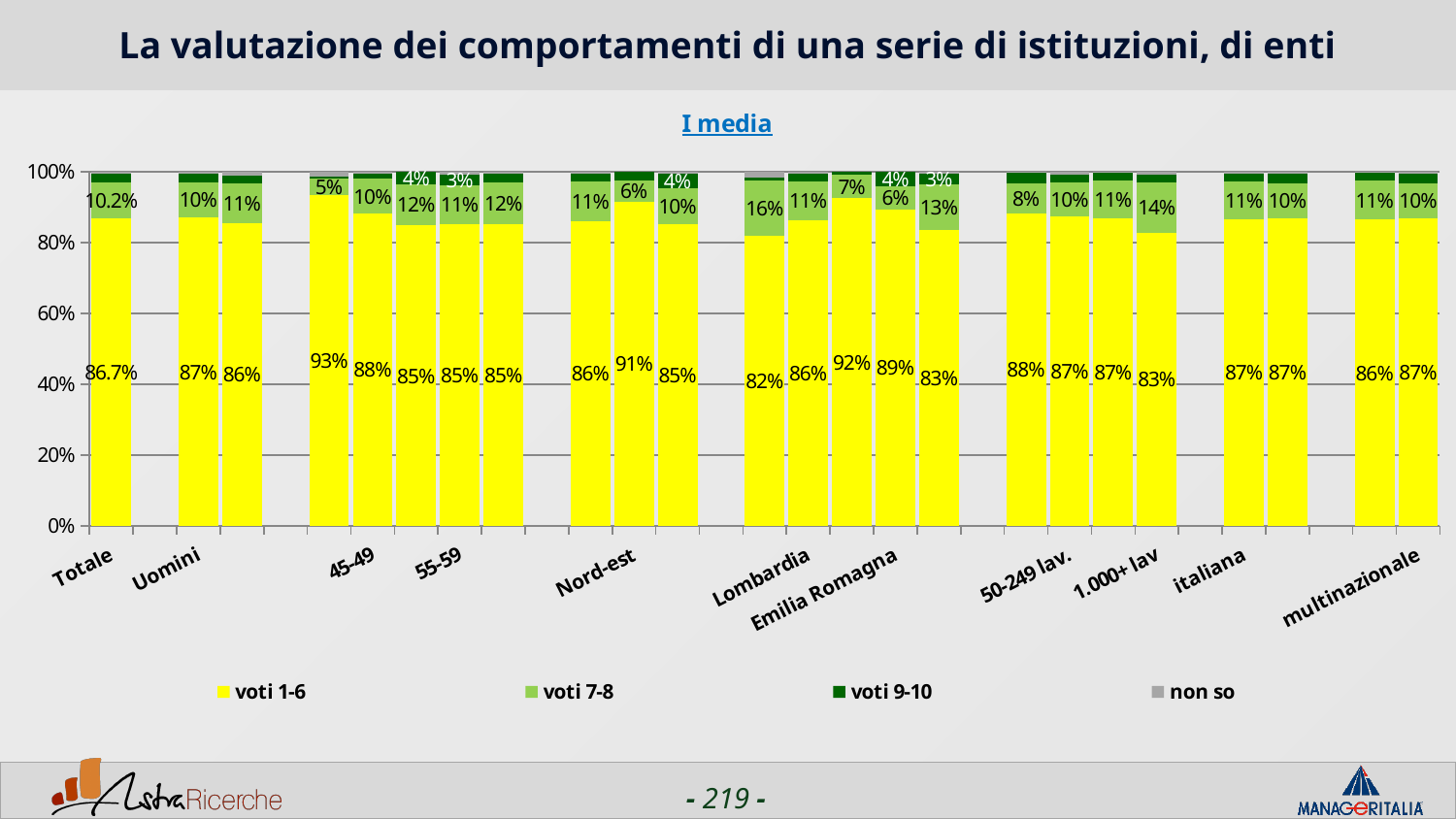
What is the lowest 'voti 1-6' value shown in the chart? 82% Is the 'voti 1-6' value for Totale greater or less than 80%? greater What kind of chart is shown on the slide? Stacked bar chart What is the 'voti 7-8' value for Nord-est? 6% What is the 'voti 1-6' value for Nord-est? 91% What is the highest 'voti 1-6' value shown in the chart? 93% What is the 'voti 1-6' value for Uomini? 87% What is the 'voti 1-6' value for Totale? 86.7% What is the 'voti 7-8' value for Totale? 10.2% What is the subtitle of the chart? I media How many series does the legend list? 4 Which has a larger 'voti 1-6' value, Totale or Nord-est? Nord-est